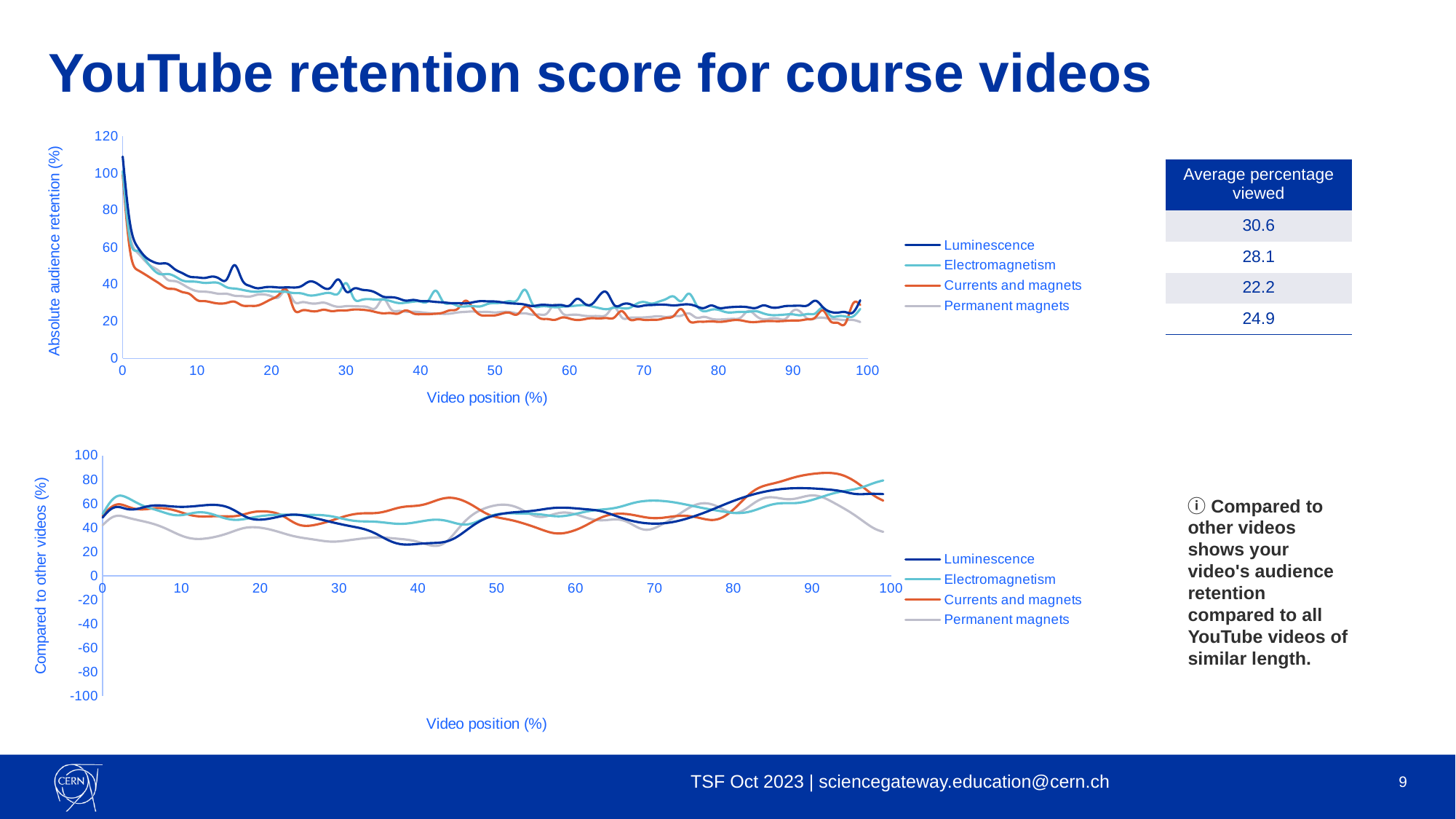
In the top chart, which series is lowest at video position 80? Currents and magnets In the bottom chart, is the value for Luminescence at video position 40 greater or less than 40? less In the top chart, is the value for Luminescence at video position 0 greater or less than 100? greater What kind of chart is the top chart (Absolute audience retention)? line chart In the bottom chart, is the value for Currents and magnets at video position 90 greater or less than 60? greater What is the x-axis label of the bottom chart (Compared to other videos)? Video position (%) Which series is shown in orange in the legend of the bottom chart? Currents and magnets In the bottom chart, which is larger at video position 100: Electromagnetism or Permanent magnets? Electromagnetism In the top chart, which series is highest at video position 10? Luminescence How many series does the legend of the top chart list? 4 In the top chart, do the absolute audience retention values generally rise or fall as video position increases? fall